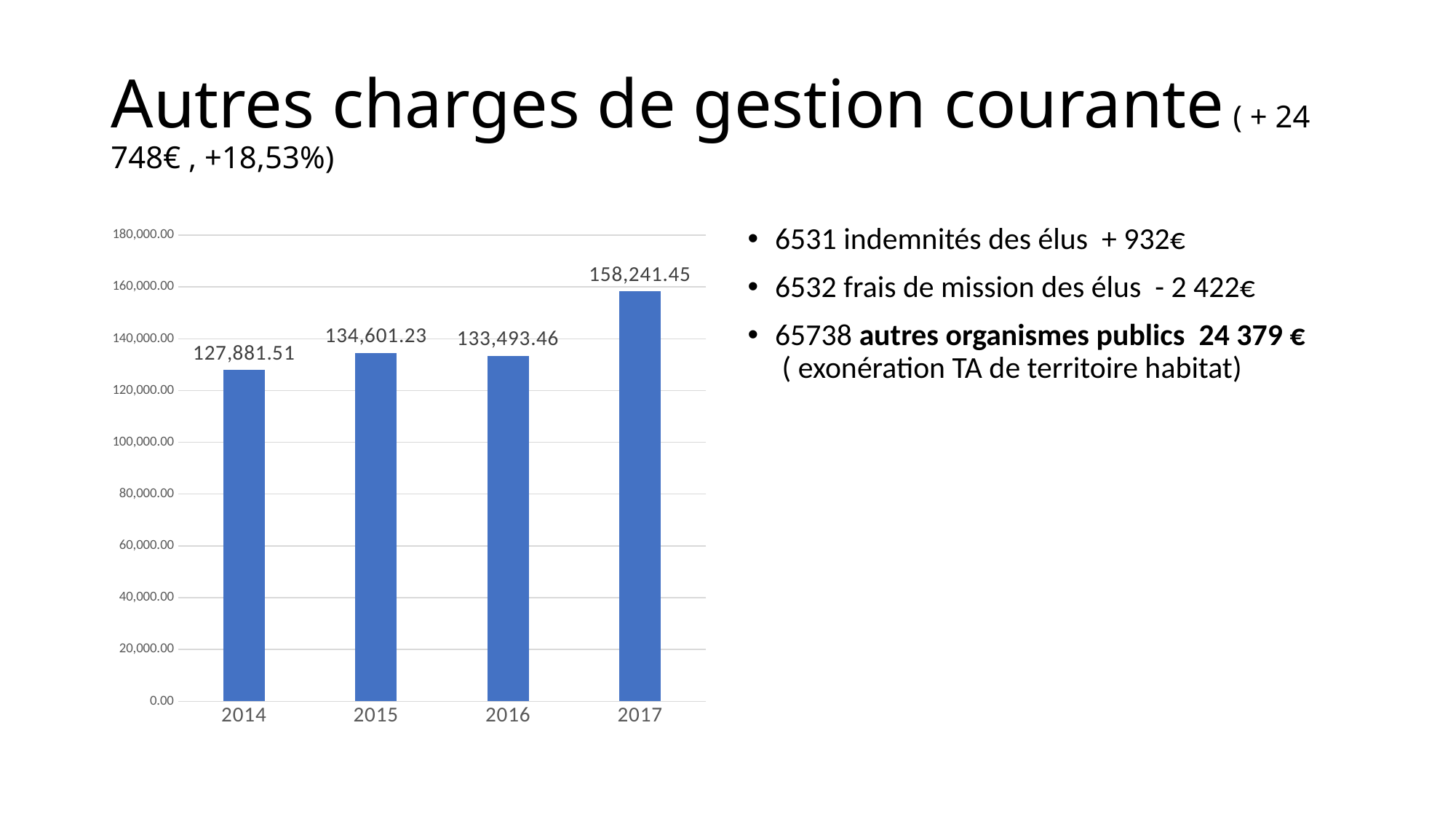
What is the difference between the values for 2017 and 2016? 24,747.99 Which year has the lowest value? 2014 Is the value for 2014 greater or less than 140,000.00? less Which is larger, the value for 2015 or the value for 2016? 2015 How many years are shown on the x axis? 4 What is the difference between the values for 2015 and 2014? 6,719.72 What kind of chart is shown on the slide? bar chart What is the value for 2014? 127,881.51 What is the value for 2017? 158,241.45 What is the value for 2016? 133,493.46 What is the value for 2015? 134,601.23 Which year has the highest value? 2017